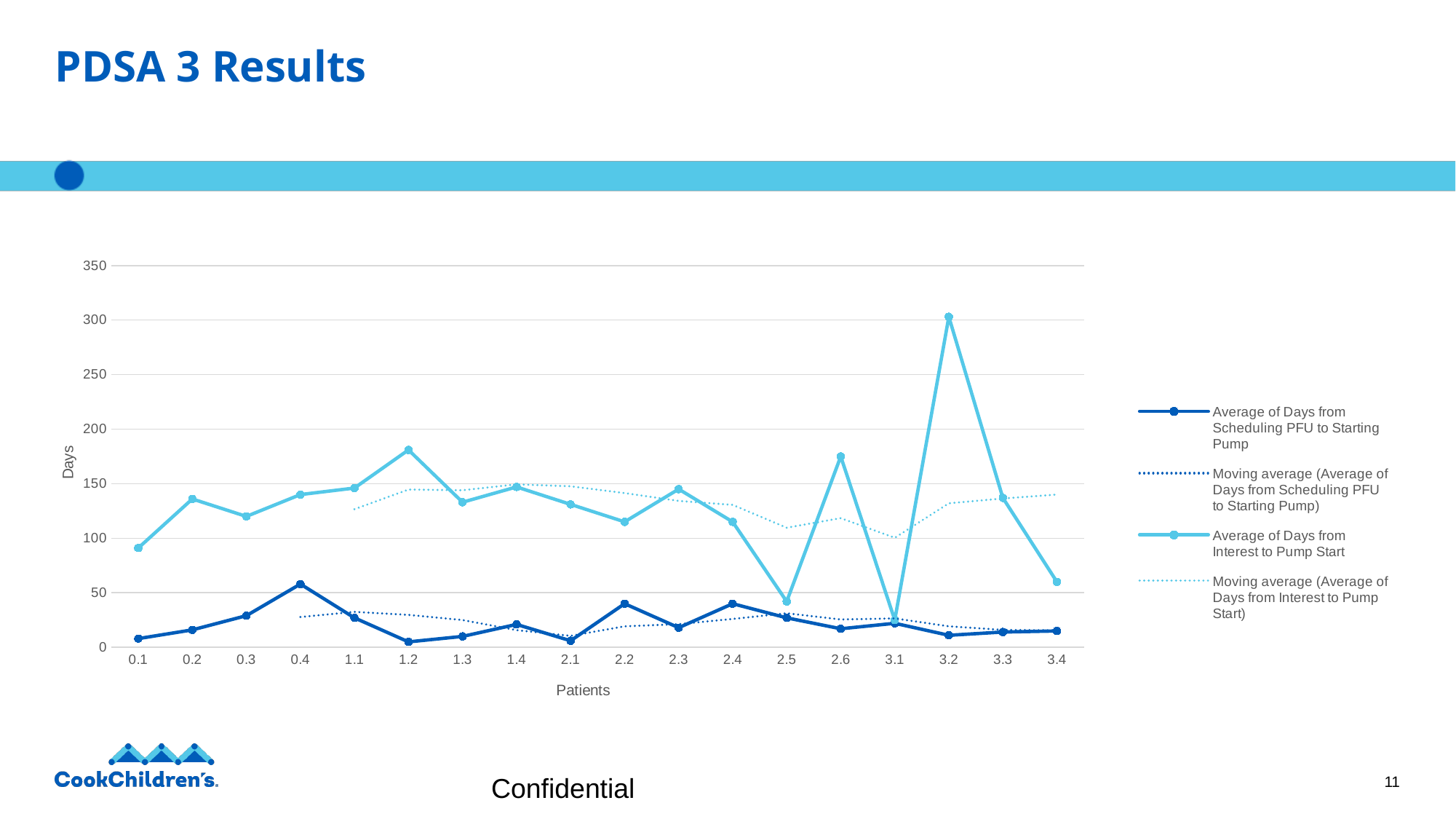
At which patient does the 'Average of Days from Scheduling PFU to Starting Pump' series reach its highest value? 0.4 Is the value for patient 0.4 in the 'Average of Days from Scheduling PFU to Starting Pump' series greater or less than 50? greater What kind of chart is shown on the slide? line chart At which patient does the 'Average of Days from Interest to Pump Start' series reach its lowest value? 3.1 Is the value for patient 2.5 in the 'Average of Days from Interest to Pump Start' series greater or less than 100? less What is the label of the y axis? Days At which patient does the 'Average of Days from Interest to Pump Start' series reach its highest value? 3.2 At patient 1.2, which series has the larger value: 'Average of Days from Interest to Pump Start' or 'Average of Days from Scheduling PFU to Starting Pump'? Average of Days from Interest to Pump Start How many series does the legend list? 4 Is the value for patient 3.2 in the 'Average of Days from Interest to Pump Start' series greater or less than 250? greater Does the 'Average of Days from Interest to Pump Start' series rise or fall from patient 3.2 to patient 3.4? fall How many patient categories are shown on the x axis? 18